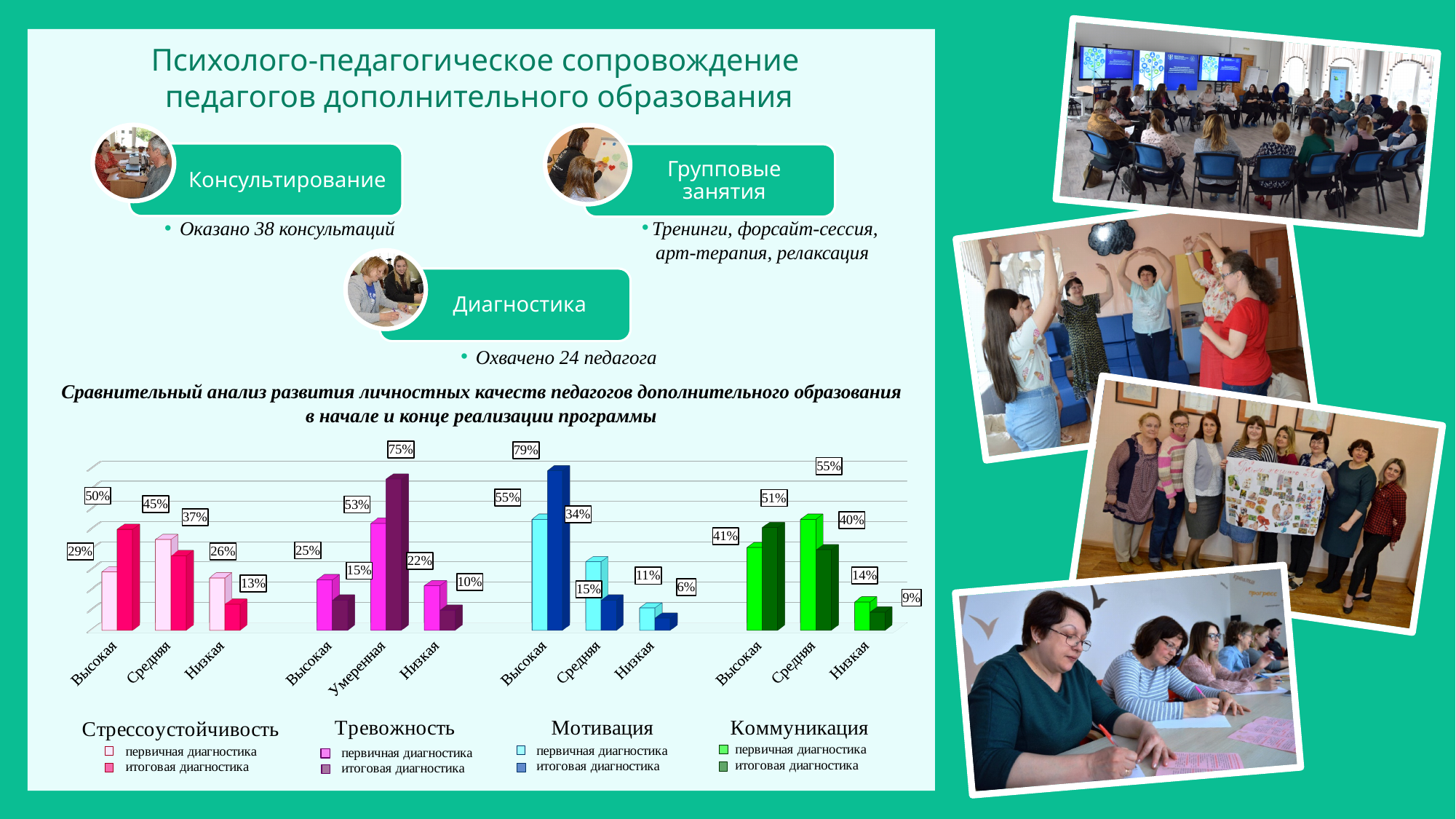
How many quality groups (Стрессоустойчивость, Тревожность, Мотивация, Коммуникация) are shown in the chart? 4 Which bar in the whole chart has the highest value? Мотивация, Высокая, итоговая диагностика (79%) Which bar in the whole chart has the lowest value? Мотивация, Низкая, итоговая диагностика (6%) What is the value for итоговая диагностика at Высокая in the Стрессоустойчивость group? 50% What is the value for первичная диагностика at Низкая in the Коммуникация group? 14% How many legend entries are listed under the Мотивация group? 2 In the Коммуникация group at Средняя, which is larger: первичная диагностика or итоговая диагностика? первичная диагностика What type of chart is shown on the slide? bar chart What is the value for первичная диагностика at Умеренная in the Тревожность group? 53% What is the value for итоговая диагностика at Высокая in the Мотивация group? 79% What is the difference between итоговая диагностика and первичная диагностика at Умеренная in the Тревожность group? 22% What colour are the bars for the Мотивация group? blue